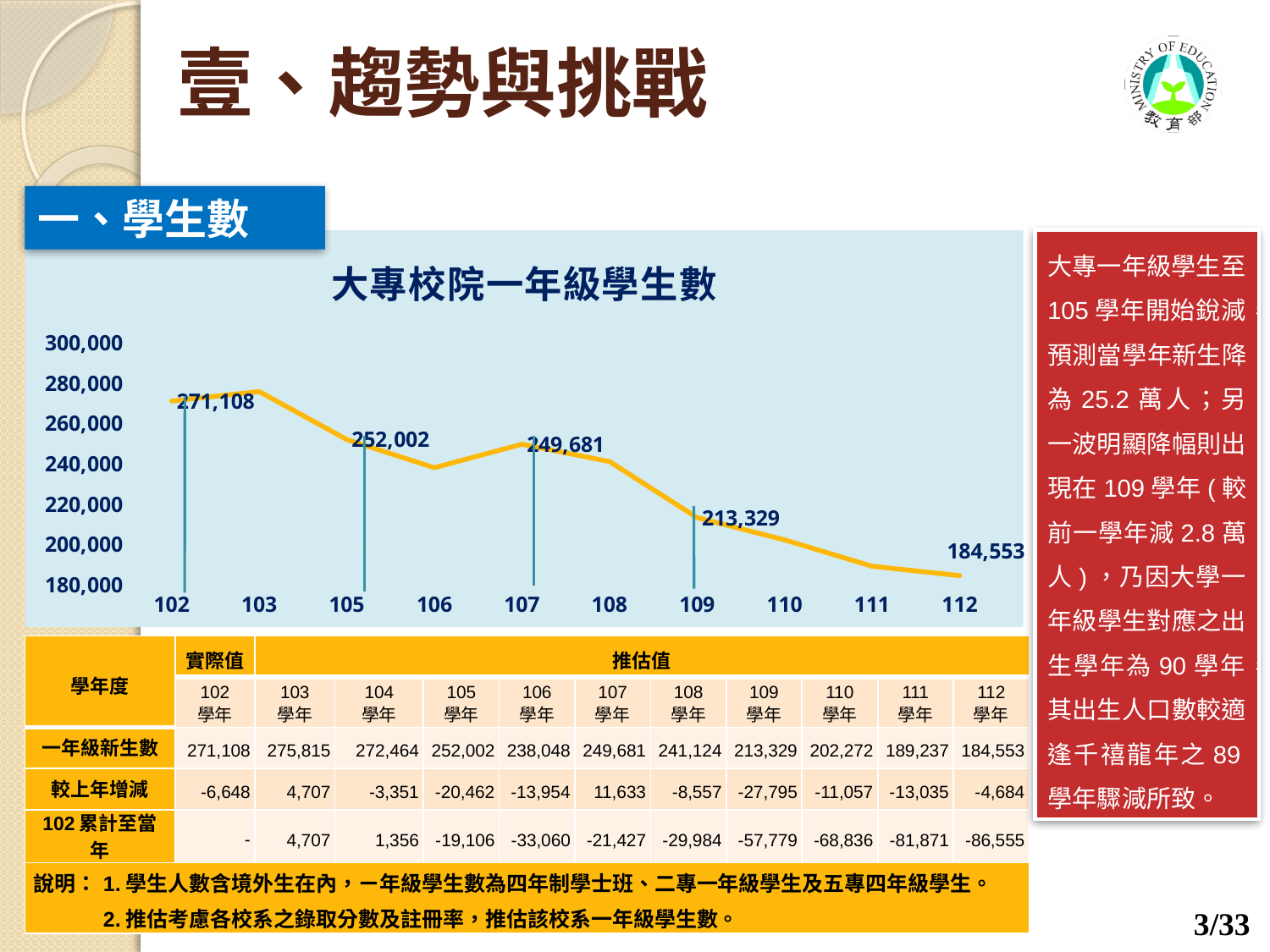
What is the value labelled on the chart for 109 學年? 213,329 What is the difference between the labelled values for 102 and 112? 86,555 Is the value for 111 greater or less than 200,000? less Which year on the x axis has the highest value? 103 What is the difference between the labelled values for 107 and 109? 36,352 What is the value labelled on the chart for 112 學年? 184,553 What kind of chart is shown on the slide? line chart Which year on the x axis has the lowest value? 112 Which is larger, the value for 105 or the value for 107? 105 What is the title of the chart? 大專校院一年級學生數 Do the values generally rise or fall from 102 to 112 along the x axis? fall What is the value labelled on the chart for 102 學年? 271,108